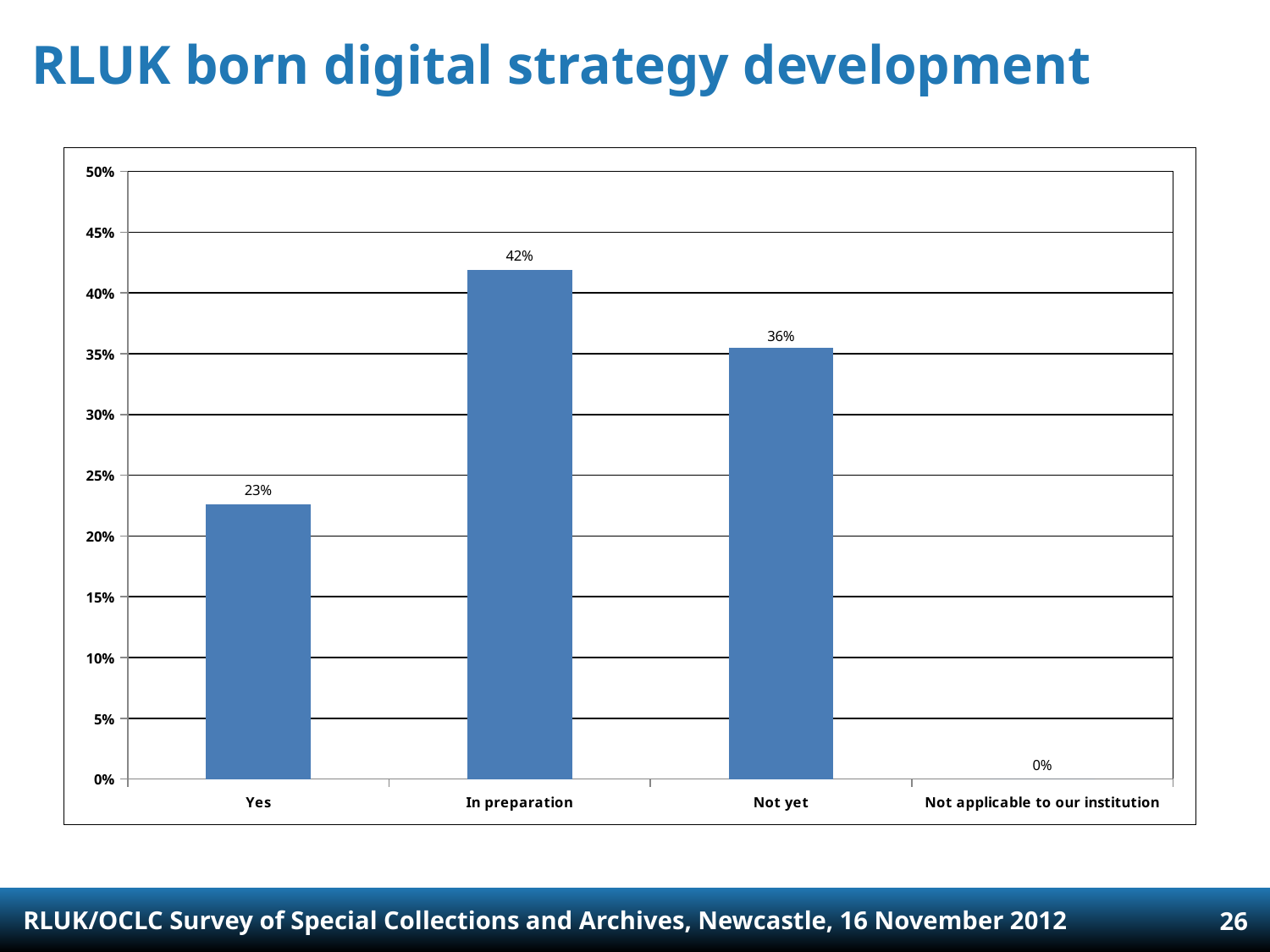
What is the value for "Yes"? 23% Is the value for "In preparation" greater or less than 40%? greater Which category has the highest value? In preparation What is the value for "Not yet"? 36% What kind of chart is shown on the slide? bar chart What is the value for "Not applicable to our institution"? 0% What is the value for "In preparation"? 42% Which is larger, the value for "Not yet" or the value for "Yes"? Not yet What is the difference between the values for "Not yet" and "Yes"? 13% Which category has the lowest value? Not applicable to our institution How many categories are shown on the x axis? 4 What is the difference between the values for "In preparation" and "Yes"? 19%